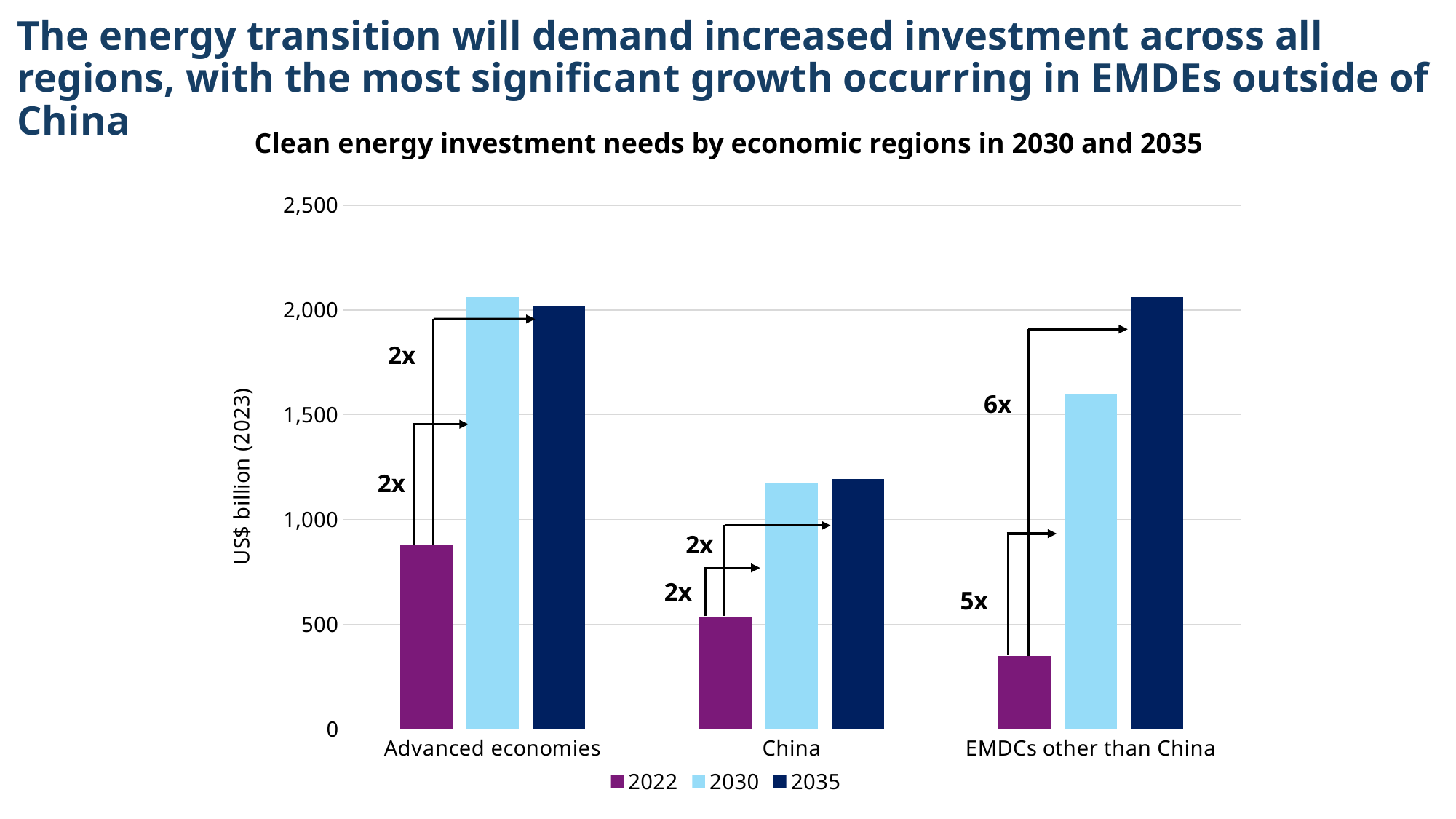
How many economic regions are shown on the x axis? 3 What multiplier is annotated for the increase from 2022 to 2035 for EMDCs other than China? 6x What kind of chart is shown on the slide? Bar chart Which region has the lowest 2022 value? EMDCs other than China Is the 2035 value for EMDCs other than China greater or less than 2,000? greater Is the 2022 value for Advanced economies greater or less than 1,000? less For EMDCs other than China, do the values rise or fall from 2022 to 2035? rise Is the 2022 value for EMDCs other than China greater or less than 500? less Which is larger, the 2022 value for Advanced economies or the 2022 value for China? Advanced economies Which region has the lowest 2035 value? China How many series does the legend list? 3